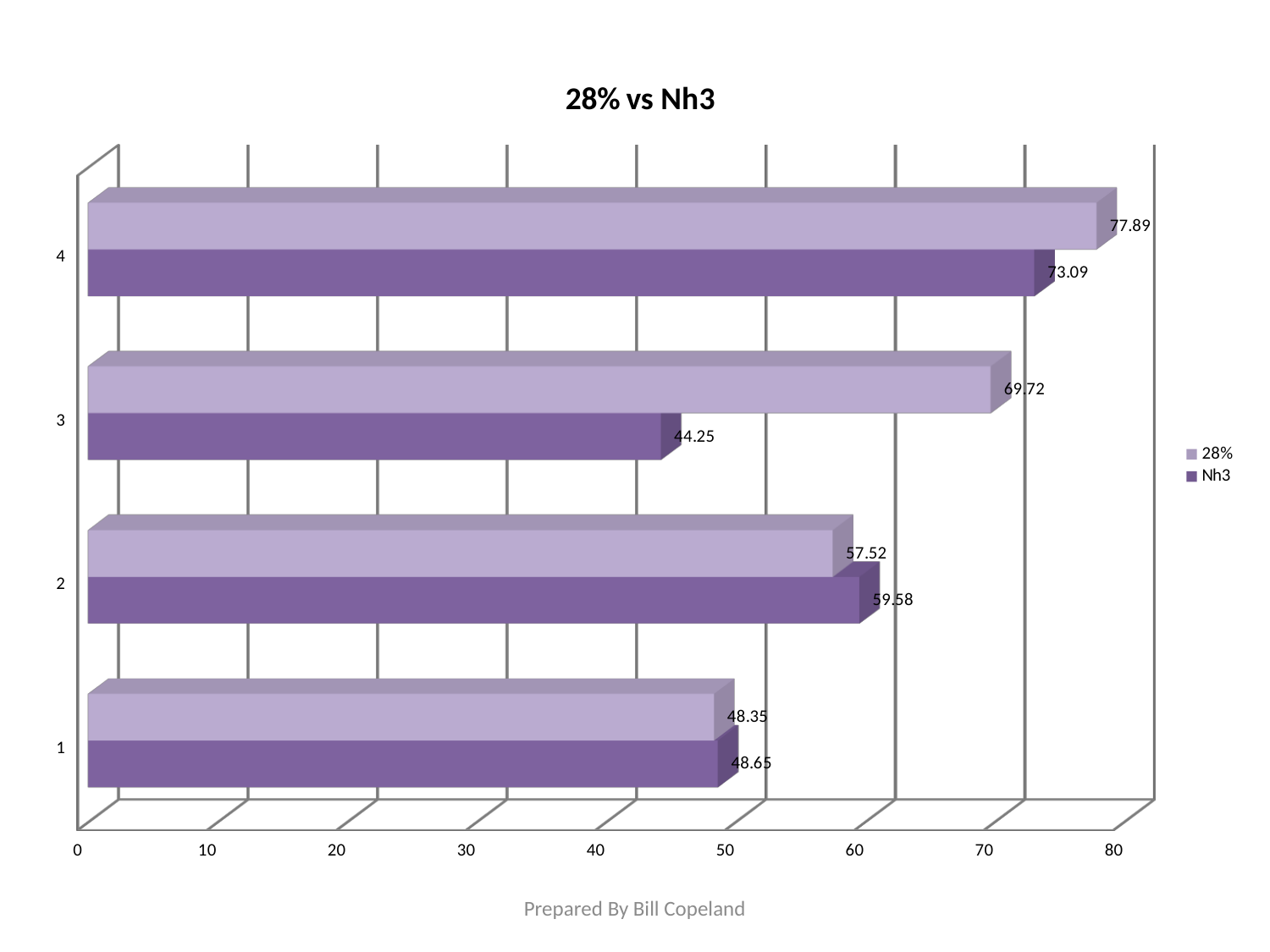
Which category has the highest value for the Nh3 series? 4 How many categories are shown on the chart? 4 What type of chart is shown on the slide? Bar chart Which category has the lowest value for the 28% series? 1 What is the value of the 28% series for category 4? 77.89 What is the value of the Nh3 series for category 3? 44.25 How many series does the legend list? 2 Is the Nh3 value for category 4 greater or less than 70? greater For category 2, which series has the larger value, 28% or Nh3? Nh3 What is the value of the 28% series for category 1? 48.35 What is the difference between the 28% and Nh3 values for category 3? 25.47 What is the value of the Nh3 series for category 2? 59.58